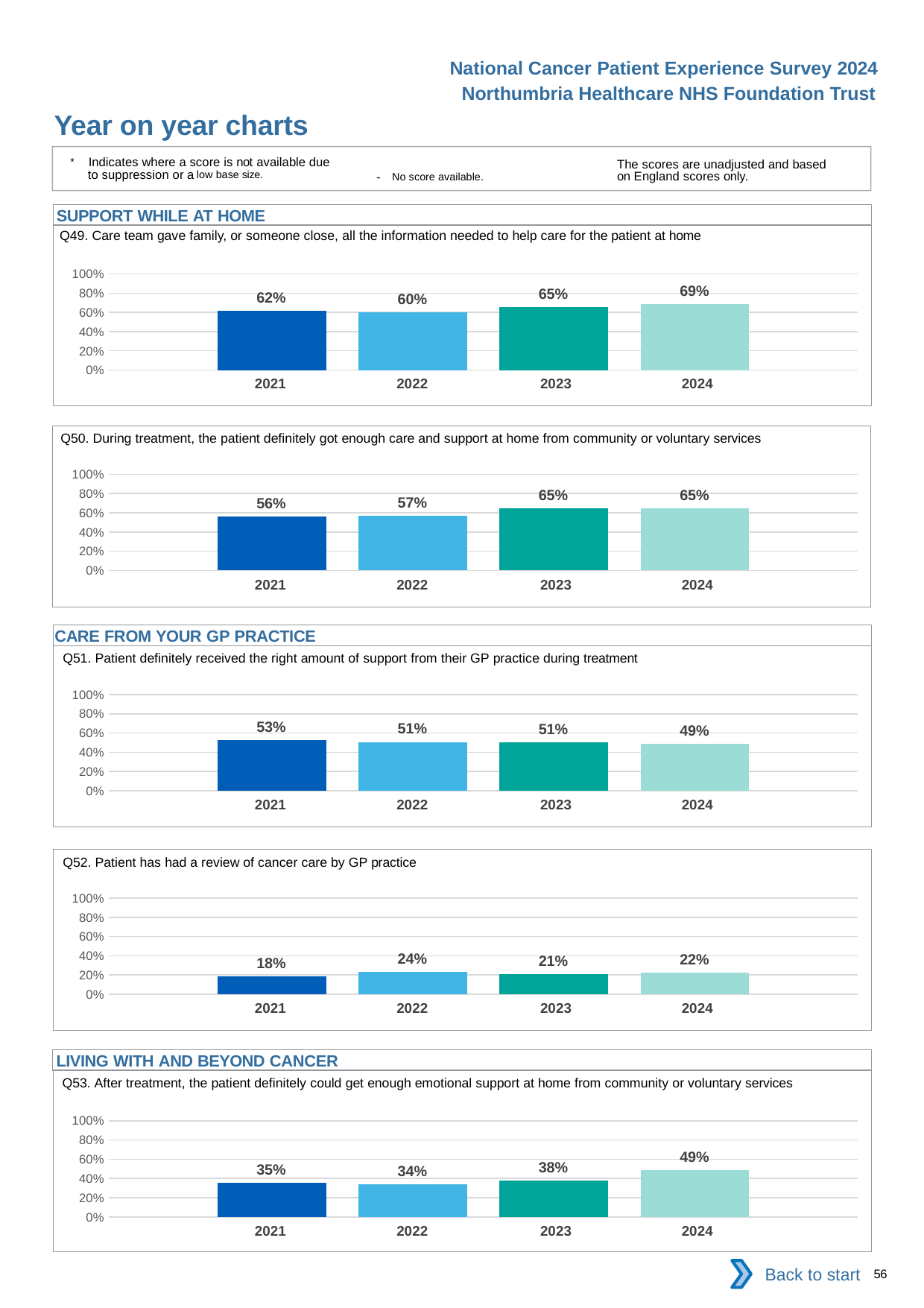
In the Q53 chart, what is the difference between the 2024 and 2023 values? 11 percentage points In the Q53 chart, which is larger, the value for 2021 or 2022? 2021 In the Q52 chart, is the value for 2021 greater or less than 20%? less What type of chart is the Q52 chart? Bar chart How many years are plotted in the Q49 chart? 4 In the Q52 chart, which year has the highest value? 2022 In the Q51 chart, which year has the highest value? 2021 In the Q50 chart, what is the value for 2022? 57% In the Q51 chart, what is the value for 2024? 49% In the Q49 chart, which year has the lowest value? 2022 In the Q49 chart, what is the value for 2024? 69% In the Q50 chart, what is the difference between the 2023 and 2021 values? 9 percentage points